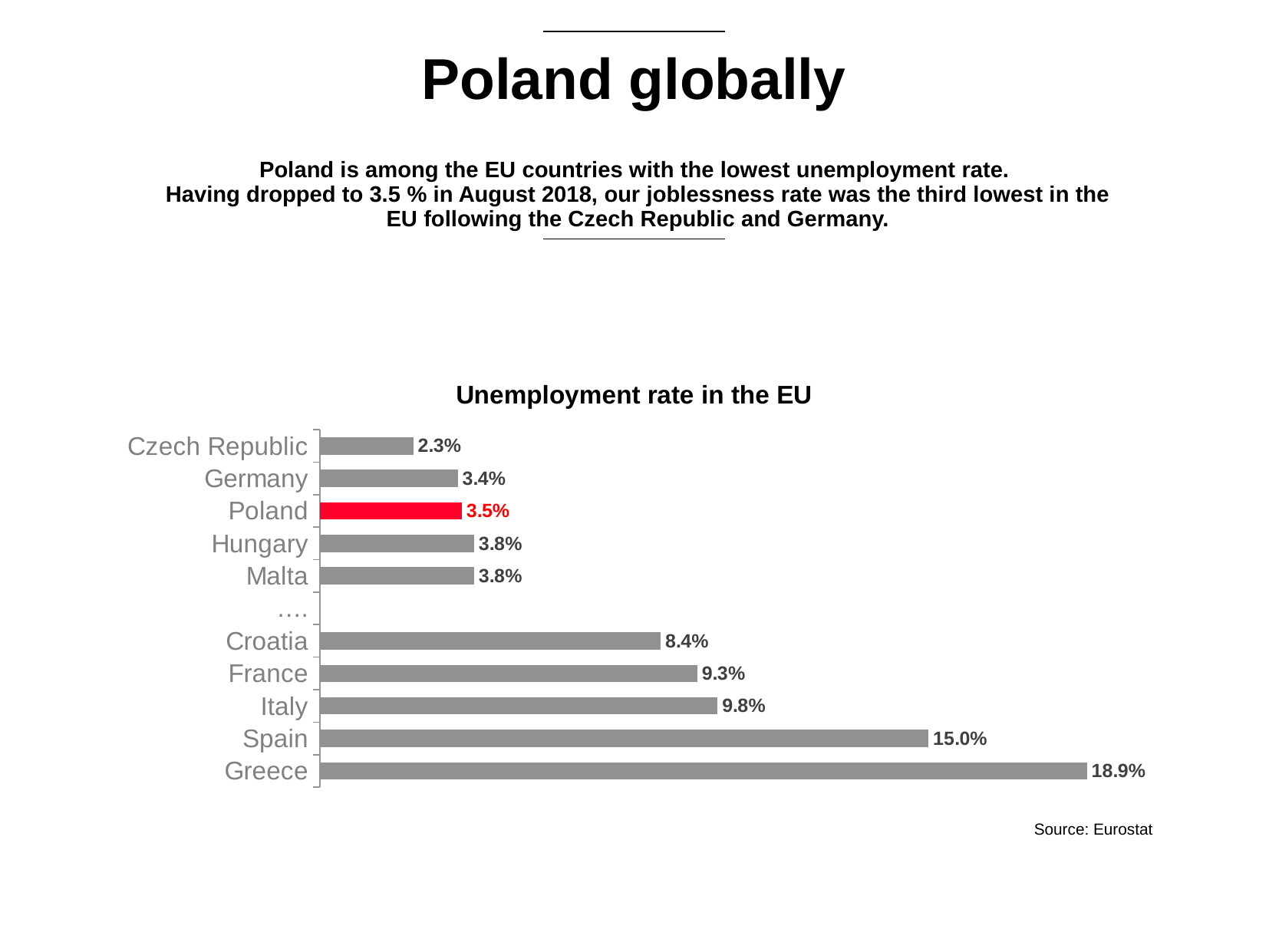
Which country's bar is highlighted in red? Poland What is the unemployment rate shown for Poland? 3.5% Which has a higher unemployment rate, France or Croatia? France How many countries have bars plotted in the chart? 10 What is the unemployment rate shown for Greece? 18.9% What is the unemployment rate shown for Croatia? 8.4% Which country has the highest unemployment rate in the chart? Greece Which country has the lowest unemployment rate in the chart? Czech Republic What is the difference between the unemployment rates of Spain and Italy? 5.2% Which has a higher unemployment rate, Germany or Poland? Poland What is the difference between the unemployment rates of Poland and the Czech Republic? 1.2% What type of chart is shown on the slide? Bar chart